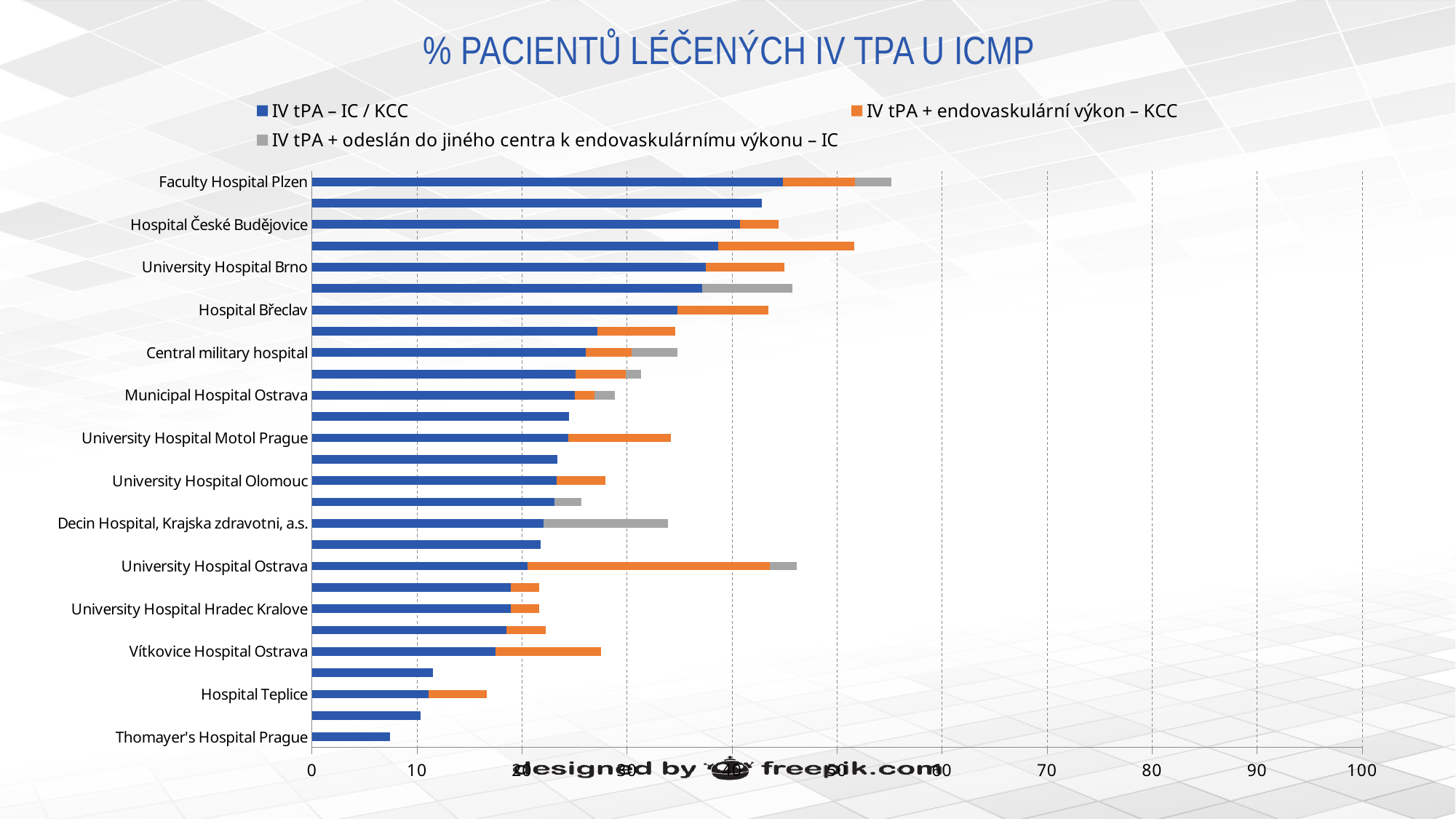
Which labelled hospital has the longest total bar? Faculty Hospital Plzen What is the title of the chart? % PACIENTŮ LÉČENÝCH IV TPA U ICMP Is the value for Thomayer's Hospital Prague greater or less than 10? less Which series is shown in orange according to the legend? IV tPA + endovaskulární výkon – KCC What kind of chart is shown on the slide? Stacked horizontal bar chart Is the total bar for University Hospital Ostrava greater or less than 40? greater Do the blue IV tPA – IC / KCC segments get longer or shorter going from the top of the chart to the bottom? shorter Which has the longer total bar, University Hospital Ostrava or University Hospital Hradec Kralove? University Hospital Ostrava Is the total bar for Hospital Teplice greater or less than 20? less How many series does the legend list? 3 Which labelled hospital has the shortest total bar? Thomayer's Hospital Prague